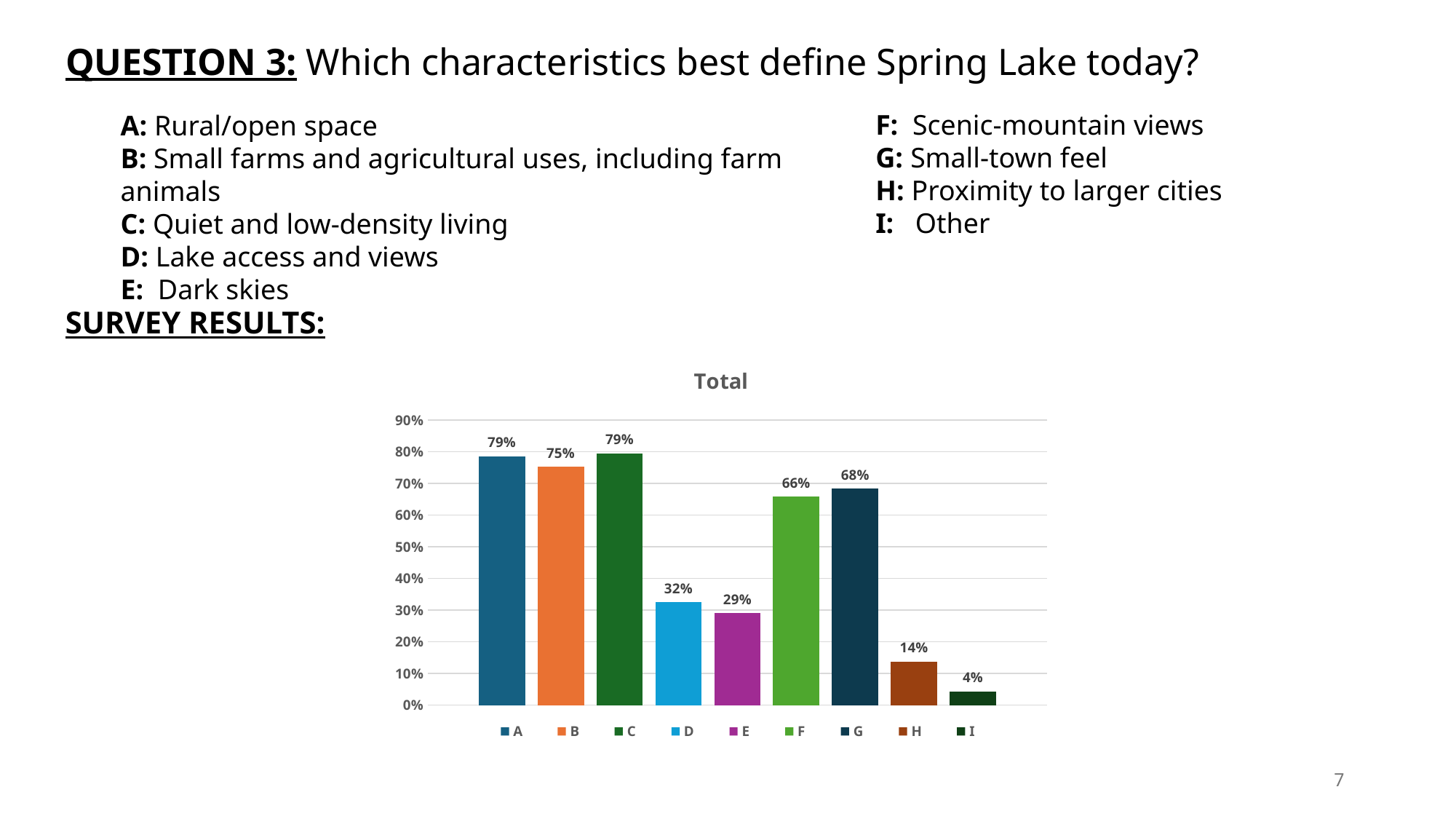
What is the difference between the values for F and G? 2% What is the value for category H in the chart? 14% What kind of chart is shown on the slide? Bar chart What is the title of the chart? Total Which category has the lowest value in the chart? I What is the difference between the values for B and E? 46% How many entries does the chart legend list? 9 Is the value for F greater or less than 60%? greater Which is larger, the value for D or the value for E? D What is the value for category D in the chart? 32% What is the value for category G in the chart? 68% How many categories are plotted in the chart? 9